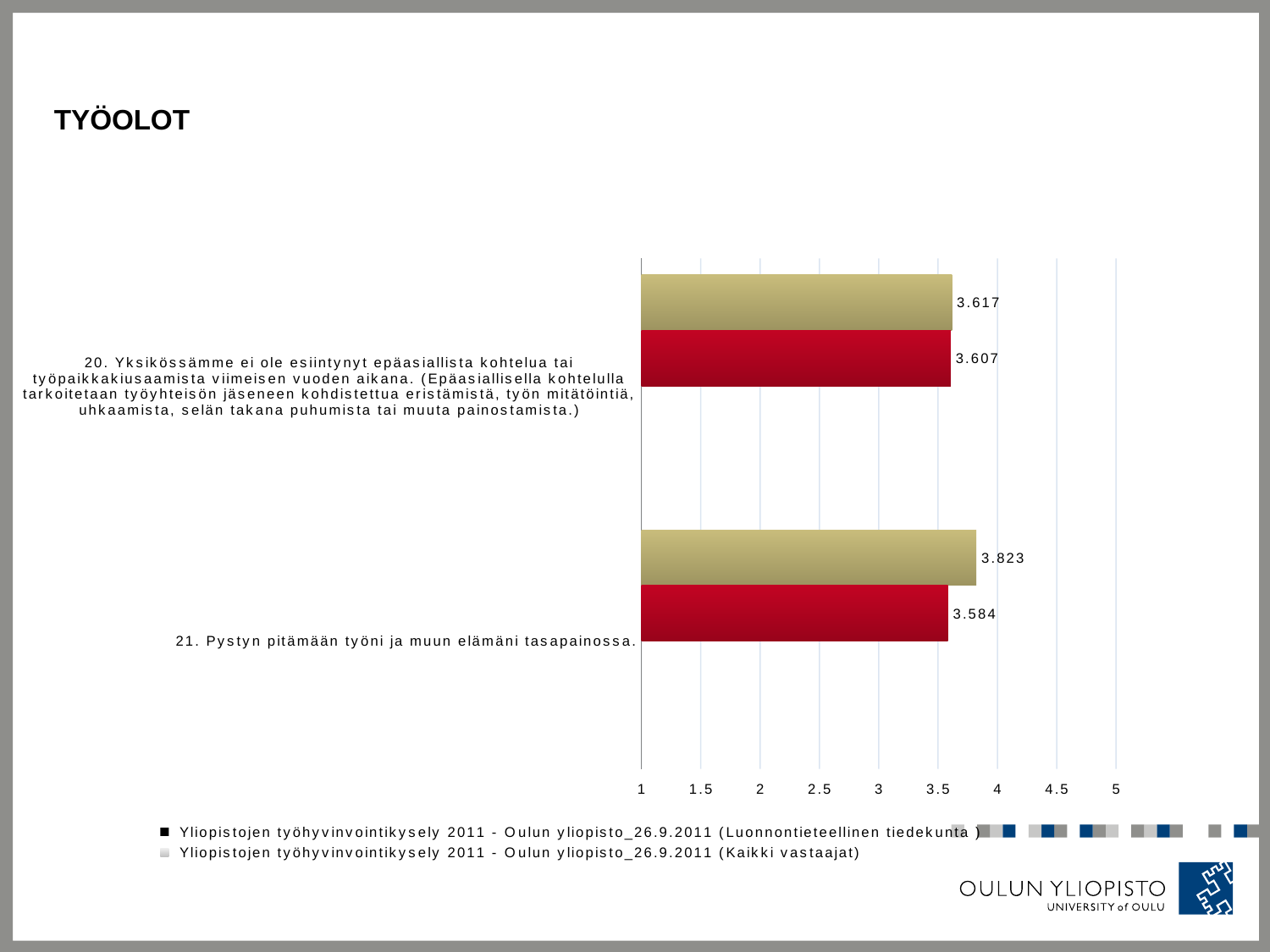
How many series does the legend list? 2 For statement 21, which bar is larger, the tan bar or the red bar? the tan bar What is the value of the tan (upper) bar for statement 20 (Yksikössämme ei ole esiintynyt epäasiallista kohtelua...)? 3.617 How many categories (survey statements) does the chart show? 2 What is the value of the red bar for statement 20 (Yksikössämme ei ole esiintynyt epäasiallista kohtelua...)? 3.607 What is the value of the red bar for statement 21 (Pystyn pitämään työni ja muun elämäni tasapainossa)? 3.584 What is the lowest value shown on the chart? 3.584 What is the value of the tan (upper) bar for statement 21 (Pystyn pitämään työni ja muun elämäni tasapainossa)? 3.823 What is the maximum value shown on the chart's horizontal axis? 5 What is the highest value shown on the chart? 3.823 What is the difference between the tan bar and the red bar for statement 21? 0.239 What kind of chart is shown on the slide? bar chart